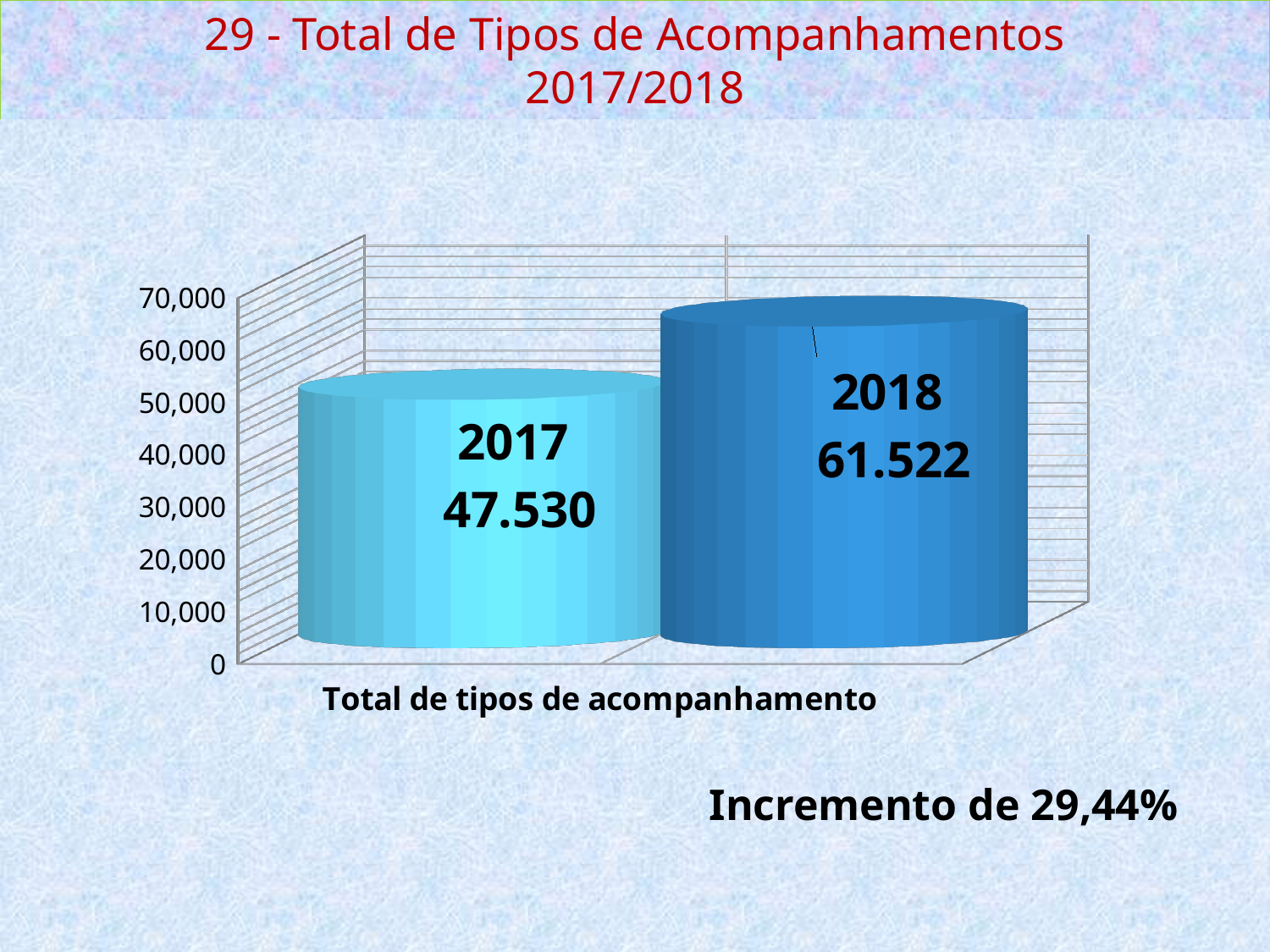
Which year has the lowest value on the chart? 2017 Do the values rise or fall from 2017 to 2018? Rise What is the difference between the 2018 value and the 2017 value? 13.992 What kind of chart is shown on the slide? Bar chart Is the value for 2018 greater or less than 60,000? greater How many bars are plotted on the chart? 2 What is the value shown for 2018? 61.522 What is the value shown for 2017? 47.530 What percentage increase is stated on the slide? 29,44% Which year has the higher value, 2017 or 2018? 2018 Which year has the highest value on the chart? 2018 Is the value for 2017 greater or less than 50,000? less